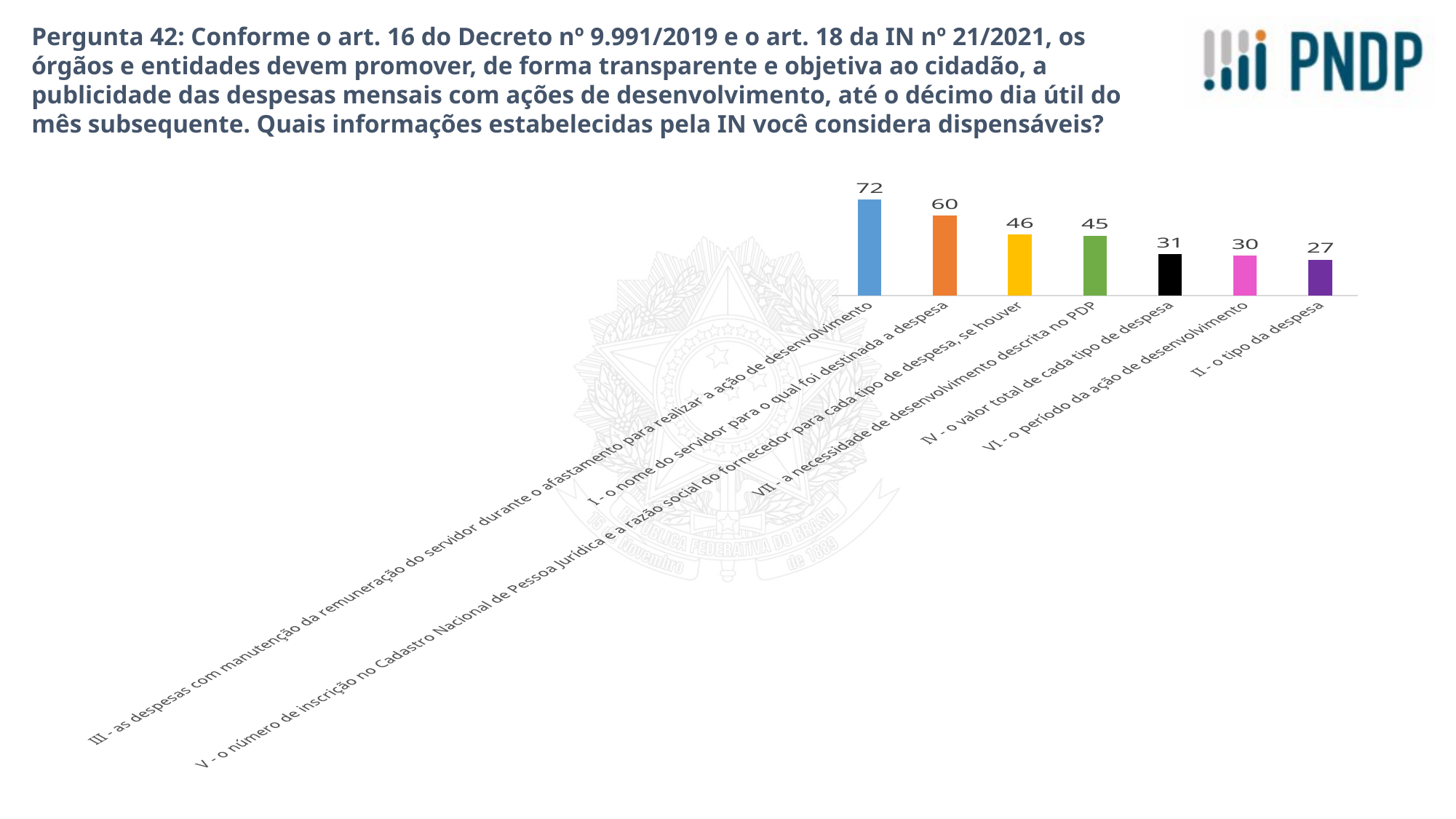
Which category has the lowest value? II - o tipo da despesa How many categories are shown in the chart? 7 What is the value for 'VII - a necessidade de desenvolvimento descrita no PDP'? 45 What is the difference between the values for 'V - o número de inscrição no Cadastro Nacional de Pessoa Jurídica e a razão social do fornecedor para cada tipo de despesa, se houver' and 'VI - o período da ação de desenvolvimento'? 16 Which category has the highest value? III - as despesas com manutenção da remuneração do servidor durante o afastamento para realizar a ação de desenvolvimento What kind of chart is shown on the slide? Bar chart What is the value for 'II - o tipo da despesa'? 27 What is the value for 'I - o nome do servidor para o qual foi destinada a despesa'? 60 Which is larger: the value for 'IV - o valor total de cada tipo de despesa' or the value for 'VI - o período da ação de desenvolvimento'? IV - o valor total de cada tipo de despesa What is the value for 'IV - o valor total de cada tipo de despesa'? 31 What colour is the bar for 'IV - o valor total de cada tipo de despesa'? Black What is the difference between the values for 'III - as despesas com manutenção da remuneração do servidor durante o afastamento para realizar a ação de desenvolvimento' and 'I - o nome do servidor para o qual foi destinada a despesa'? 12